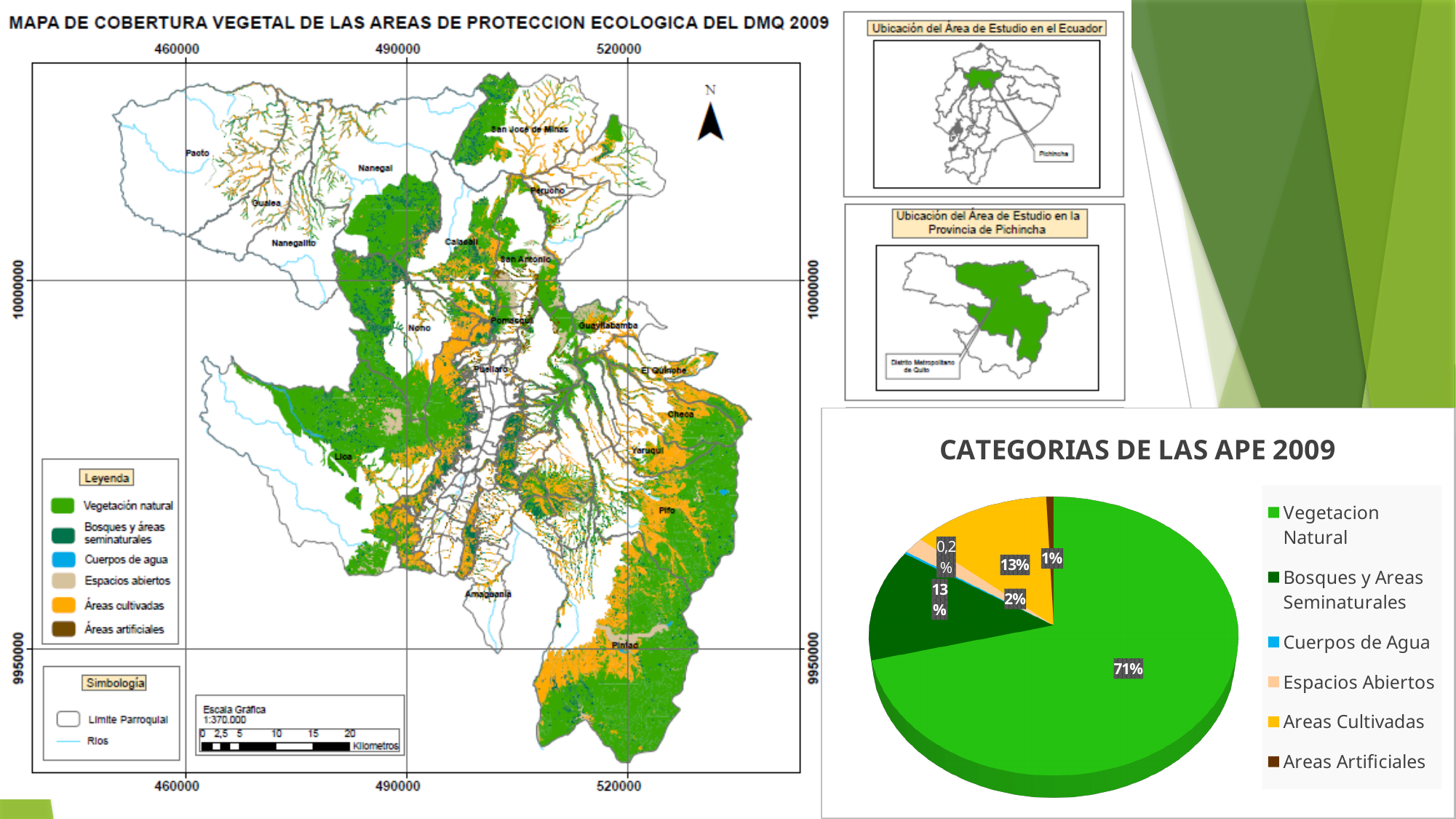
In the pie chart 'CATEGORIAS DE LAS APE 2009', what is the value for Bosques y Areas Seminaturales? 13% What type of chart is 'CATEGORIAS DE LAS APE 2009'? pie chart In the pie chart 'CATEGORIAS DE LAS APE 2009', what is the value for Areas Artificiales? 1% In the pie chart 'CATEGORIAS DE LAS APE 2009', what is the value for Areas Cultivadas? 13% In the pie chart 'CATEGORIAS DE LAS APE 2009', what share does Vegetacion Natural have? 71% In the pie chart 'CATEGORIAS DE LAS APE 2009', which category has the smallest share? Cuerpos de Agua In the pie chart 'CATEGORIAS DE LAS APE 2009', what is the value for Espacios Abiertos? 2% In the pie chart 'CATEGORIAS DE LAS APE 2009', which category has the largest share? Vegetacion Natural In the pie chart 'CATEGORIAS DE LAS APE 2009', how many percentage points larger is Vegetacion Natural than Areas Cultivadas? 58 How many categories does the legend of the pie chart 'CATEGORIAS DE LAS APE 2009' list? 6 In the pie chart 'CATEGORIAS DE LAS APE 2009', which is larger: Espacios Abiertos or Areas Artificiales? Espacios Abiertos In the pie chart 'CATEGORIAS DE LAS APE 2009', what is the value for Cuerpos de Agua? 0,2%